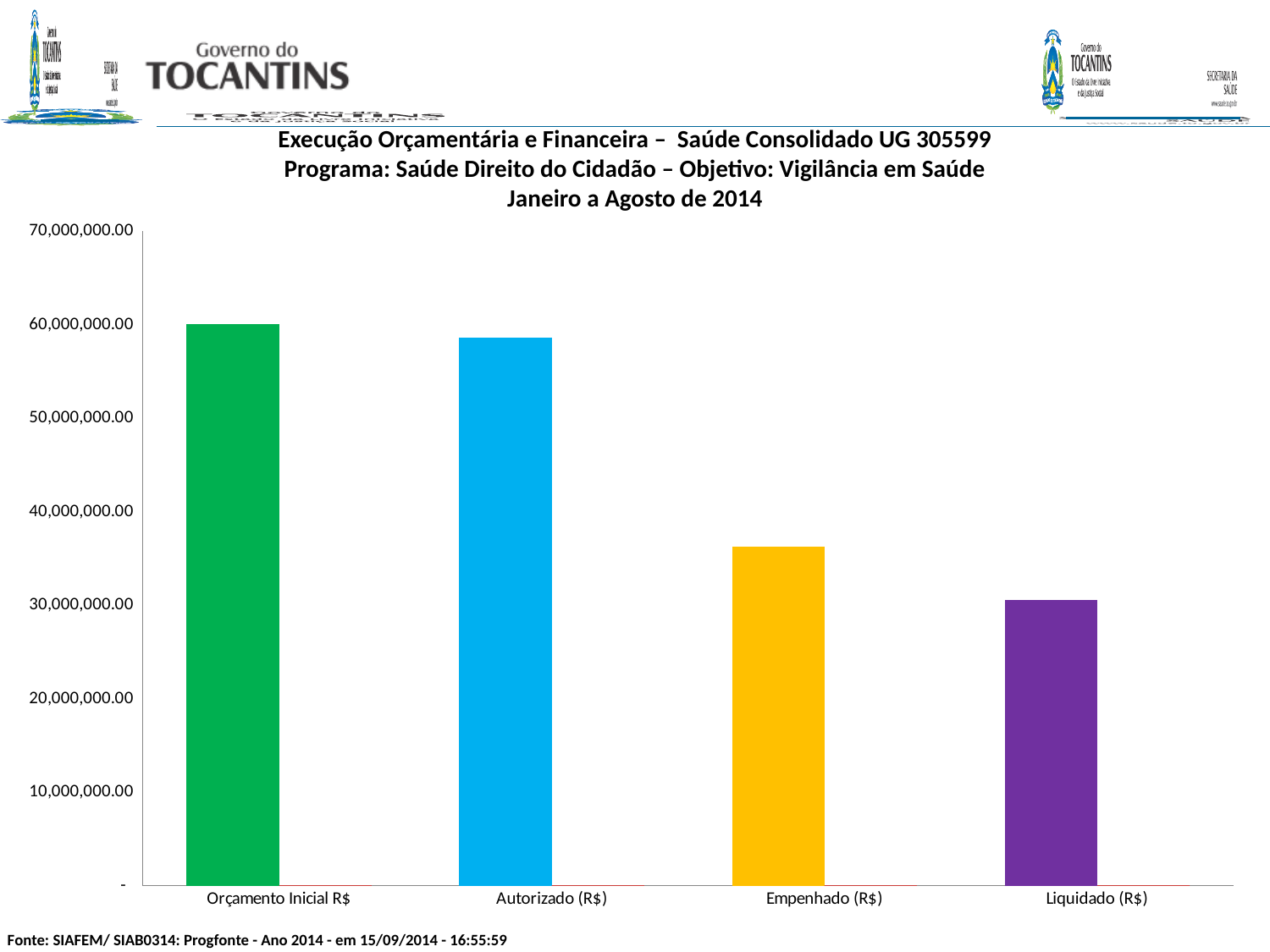
What kind of chart is shown on the slide? bar chart Is the value for Autorizado (R$) greater or less than 50,000,000.00? greater Which is larger, the value for Autorizado (R$) or the value for Empenhado (R$)? Autorizado (R$) What period does the chart title say the data covers? Janeiro a Agosto de 2014 Which category has the highest value? Orçamento Inicial R$ Do the values rise or fall from left to right along the x axis? fall Which is larger, the value for Empenhado (R$) or the value for Liquidado (R$)? Empenhado (R$) Is the value for Empenhado (R$) greater or less than 40,000,000.00? less How many categories are plotted on the x axis? 4 Is the value for Liquidado (R$) greater or less than 40,000,000.00? less Which category has the lowest value? Liquidado (R$) What colour is the bar for Liquidado (R$)? purple